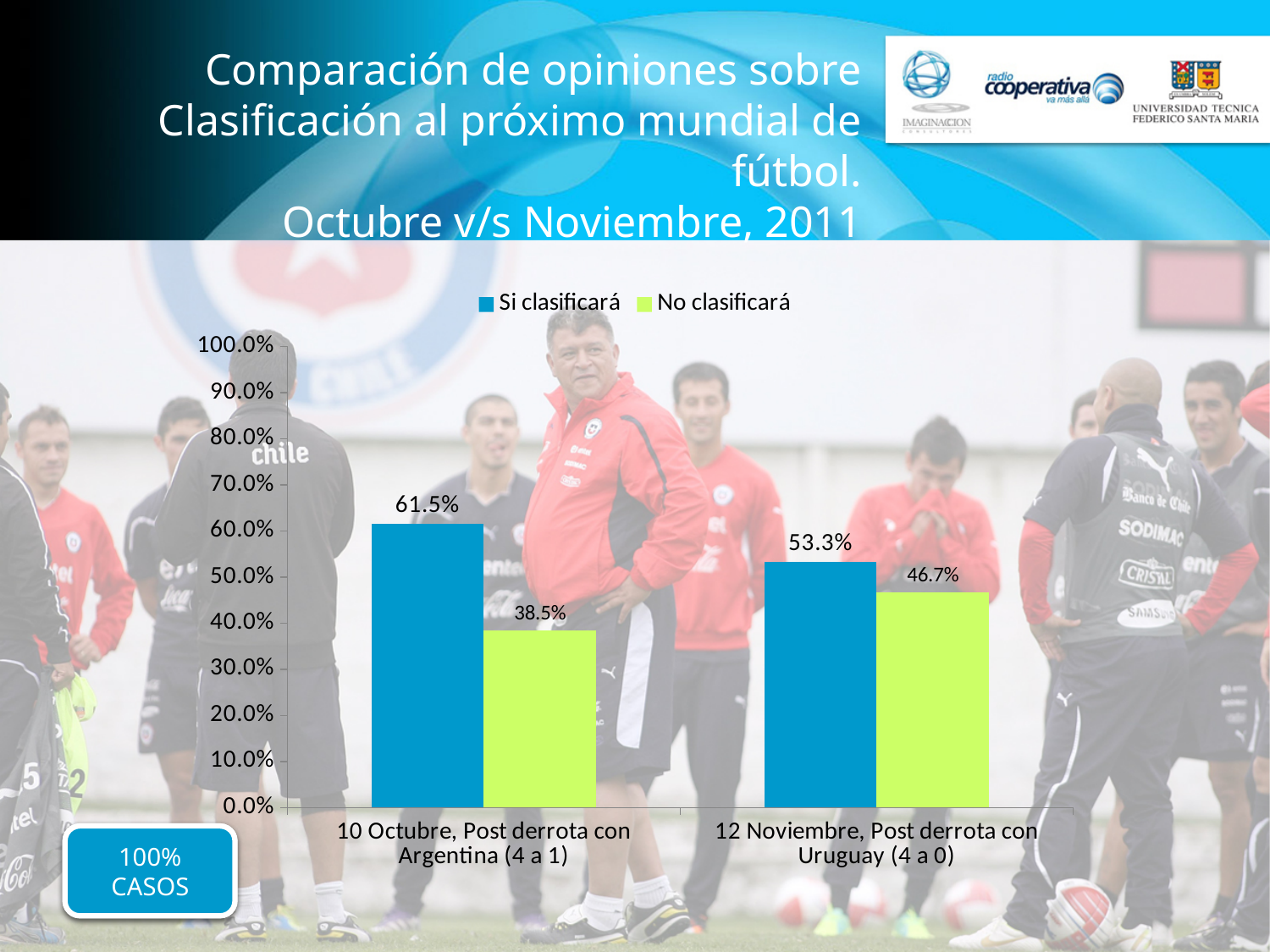
What is the value for "No clasificará" in the "10 Octubre, Post derrota con Argentina (4 a 1)" category? 38.5% How many series does the legend list? 2 Is the value for "No clasificará" in the 10 Octubre category greater or less than 40.0%? less Which bar has the lowest value on the chart? No clasificará, 10 Octubre, Post derrota con Argentina (4 a 1) What is the difference between the "Si clasificará" values for 10 Octubre and 12 Noviembre? 8.2% Which is larger in the 12 Noviembre category: "Si clasificará" or "No clasificará"? Si clasificará What is the value for "Si clasificará" in the "10 Octubre, Post derrota con Argentina (4 a 1)" category? 61.5% What kind of chart is shown on the slide? bar chart What is the value for "No clasificará" in the "12 Noviembre, Post derrota con Uruguay (4 a 0)" category? 46.7% Which bar has the highest value on the chart? Si clasificará, 10 Octubre, Post derrota con Argentina (4 a 1) How many categories are shown on the x axis? 2 What is the value for "Si clasificará" in the "12 Noviembre, Post derrota con Uruguay (4 a 0)" category? 53.3%